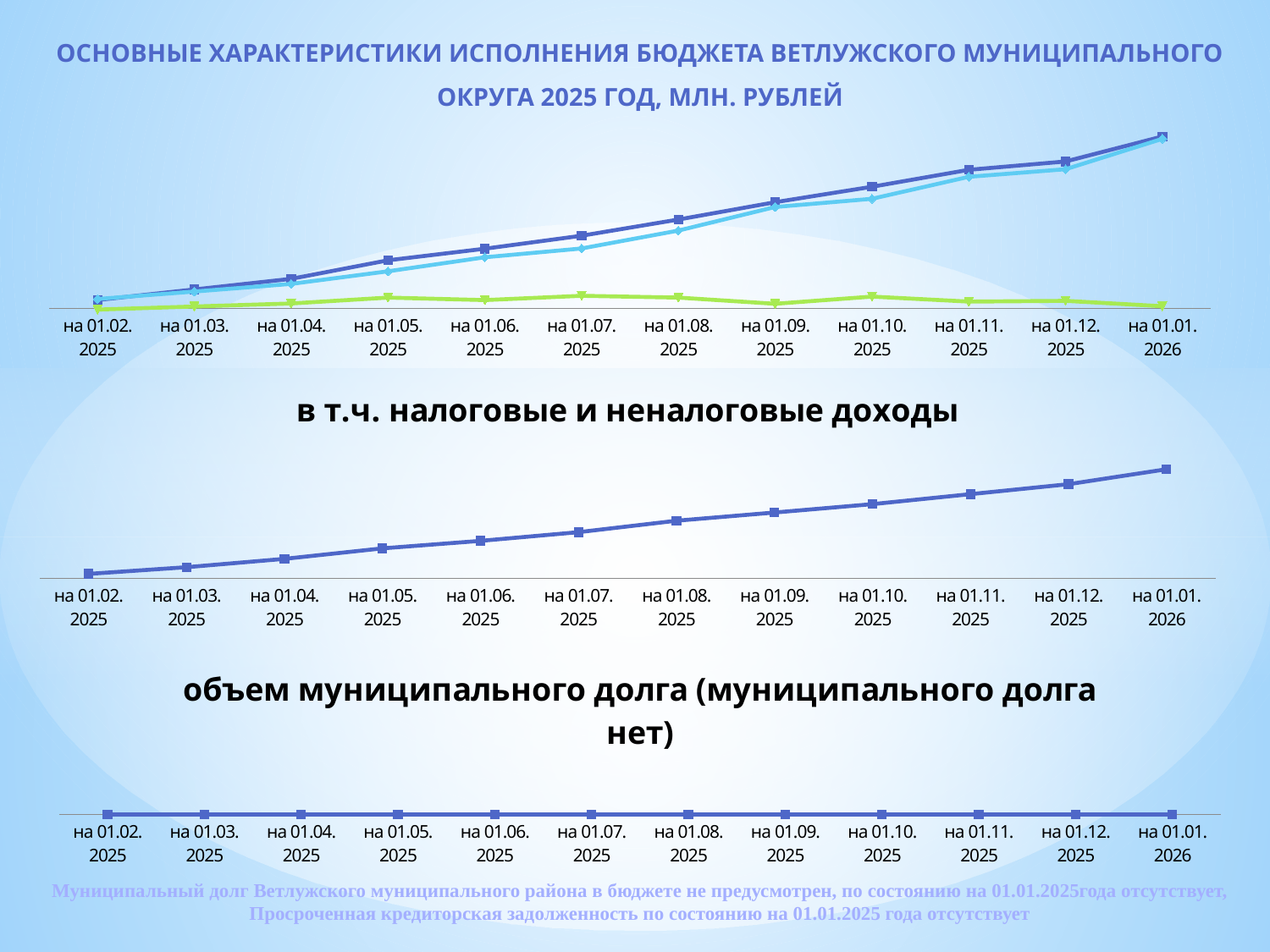
On the middle chart 'в т.ч. налоговые и неналоговые доходы', do the values rise or fall along the x axis? Rise On the middle chart 'в т.ч. налоговые и неналоговые доходы', which is larger: the value at 'на 01.01.2026' or at 'на 01.02.2025'? на 01.01.2026 How many lines are plotted on the top chart? 3 On the bottom chart 'объем муниципального долга (муниципального долга нет)', do the values rise, fall or stay flat along the x axis? Stay flat What is the title of the middle chart? в т.ч. налоговые и неналоговые доходы What kind of chart is the middle chart 'в т.ч. налоговые и неналоговые доходы'? Line chart On the top chart, does the dark blue line rise or fall from 'на 01.02.2025' to 'на 01.01.2026'? Rises How many dates are shown on the x axis of the top chart? 12 On the top chart, at which date is the light blue line at its lowest value? на 01.02.2025 On the top chart, at which date does the dark blue line reach its highest value? на 01.01.2026 What kind of chart is the top chart titled 'ОСНОВНЫЕ ХАРАКТЕРИСТИКИ ИСПОЛНЕНИЯ БЮДЖЕТА ВЕТЛУЖСКОГО МУНИЦИПАЛЬНОГО ОКРУГА 2025 ГОД, МЛН. РУБЛЕЙ'? Line chart How many data points are plotted on the bottom chart 'объем муниципального долга'? 12